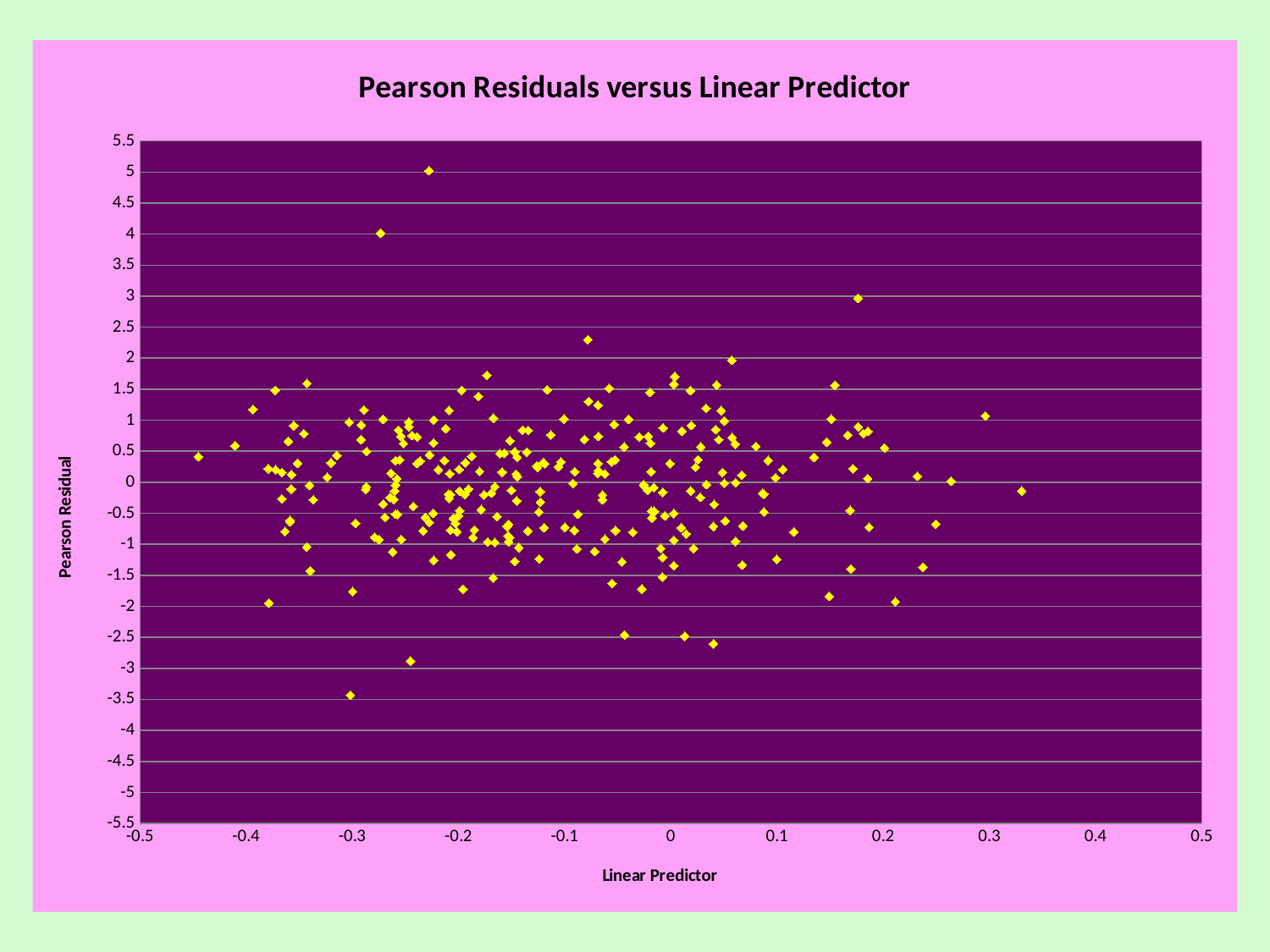
Is the Pearson residual of the second-highest point, near a linear predictor of -0.27, greater or less than 3.5? greater Is the Pearson residual of the point near a linear predictor of 0.18 (the highest point on the right half) greater or less than 2.5? greater Is the Pearson residual of the point near a linear predictor of 0.3 greater or less than 0.5? greater What is the title of the chart? Pearson Residuals versus Linear Predictor What kind of chart is shown on the slide? Scatter chart Which is higher, the highest point near a linear predictor of -0.23 or the point near a linear predictor of -0.27? The point near -0.23 What is the label of the vertical axis? Pearson Residual